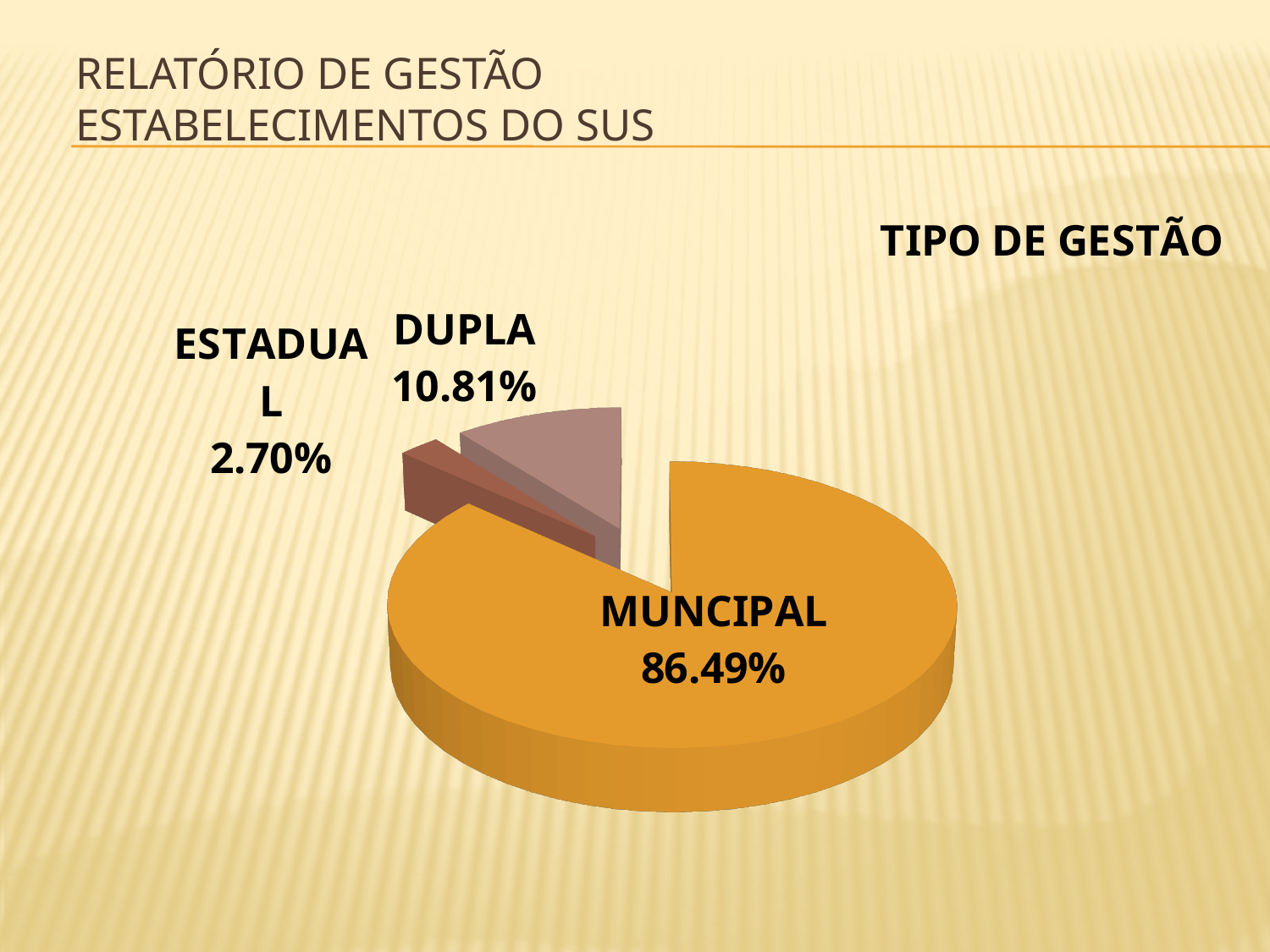
What colour is the MUNCIPAL slice? Orange What type of chart is shown on the slide? Pie chart Which category has the largest share of the pie? MUNCIPAL What is the difference between the MUNCIPAL and DUPLA percentages? 75.68% What percentage is shown for MUNCIPAL? 86.49% What is the title of the chart? TIPO DE GESTÃO What percentage is shown for DUPLA? 10.81% Which category has the smallest share of the pie? ESTADUAL Which is larger, the share for DUPLA or the share for ESTADUAL? DUPLA How many slices does the pie chart have? 3 What is the difference between the DUPLA and ESTADUAL percentages? 8.11% What percentage is shown for ESTADUAL? 2.70%